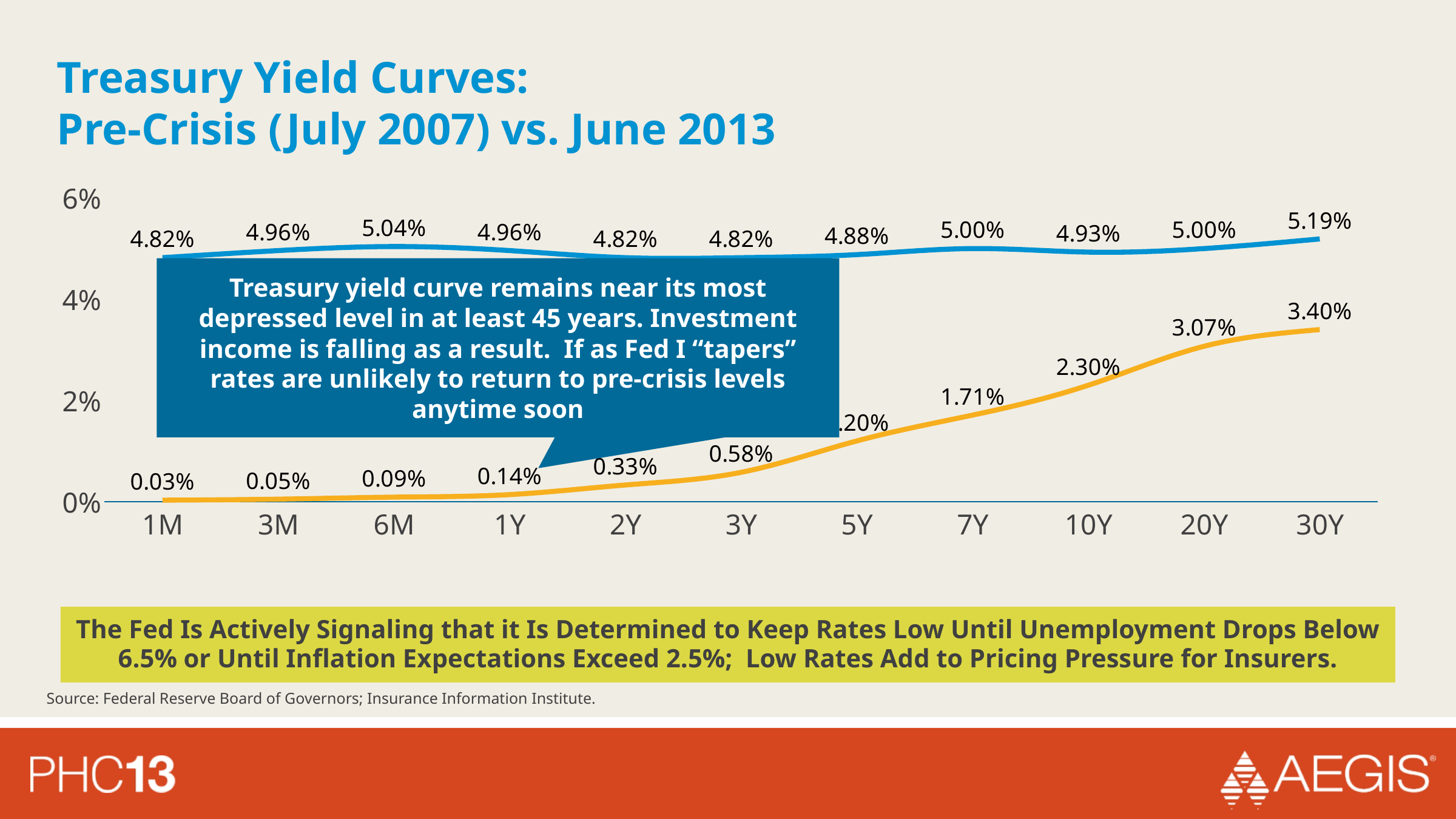
Which is larger at the 10Y maturity: the blue line value or the orange line value? The blue line (4.93%) How many maturities are shown on the x axis of the chart? 11 Does the orange line generally rise or fall as maturity increases from 1M to 30Y? Rise What is the value of the blue line at the 6M maturity? 5.04% What is the value of the blue line at the 30Y maturity? 5.19% At which maturity does the blue line reach its highest value? 30Y At which maturity is the orange line at its lowest value? 1M What is the value of the orange line at the 30Y maturity? 3.40% What is the difference between the blue line and the orange line at the 30Y maturity? 1.79% What is the title of the chart on the slide? Treasury Yield Curves: Pre-Crisis (July 2007) vs. June 2013 What is the value of the orange line at the 1M maturity? 0.03% What type of chart is shown on the slide? Line chart